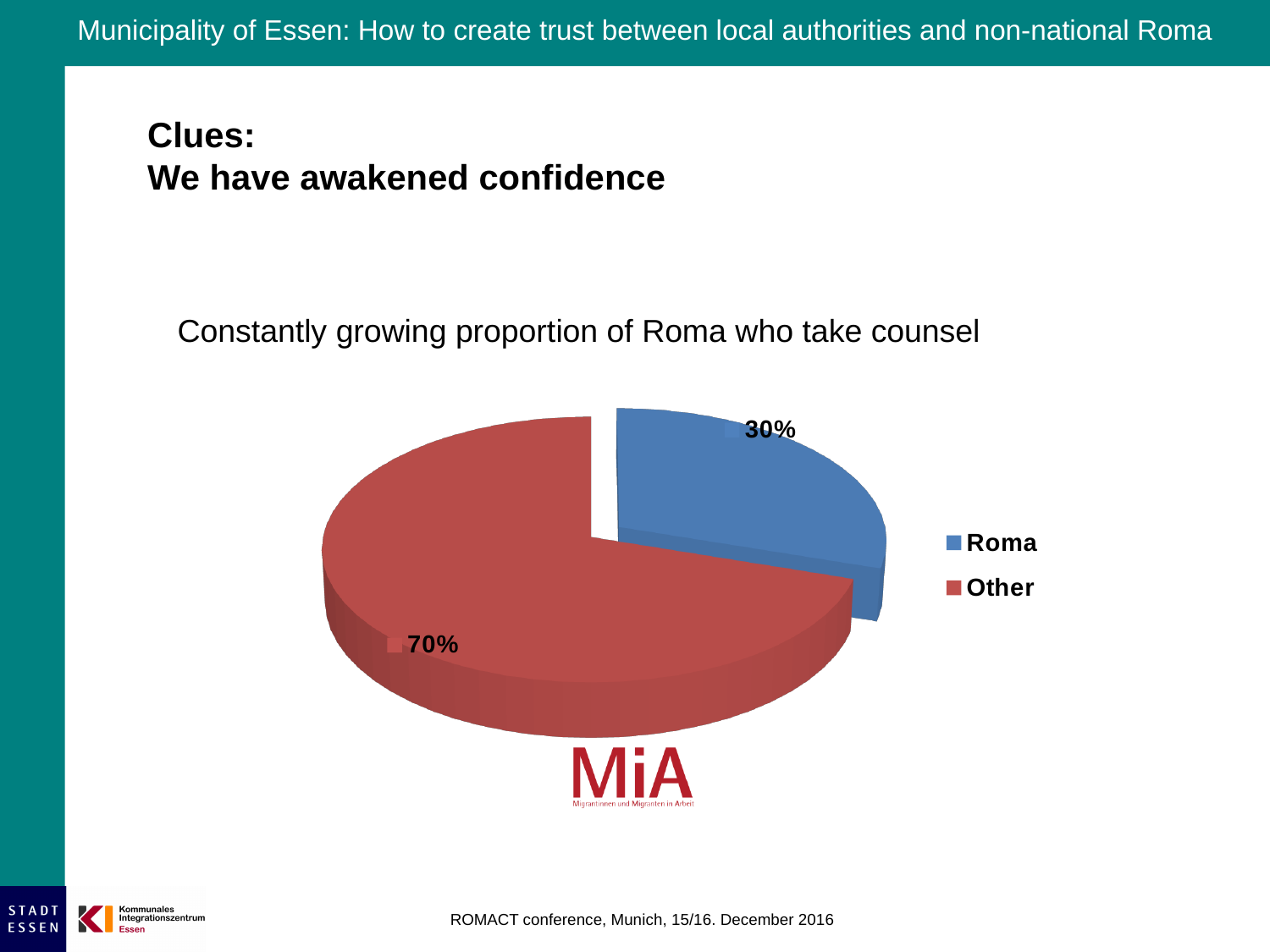
How many entries does the legend list? 2 What colour is the Roma slice in the pie chart? blue What kind of chart is shown on the slide? pie chart What percentage of the pie is labelled Other? 70% Which slice of the pie is the largest? Other How many slices does the pie chart have? 2 What colour is the Other slice in the pie chart? red Which slice is larger, Roma or Other? Other What is the difference in percentage points between the Other slice and the Roma slice? 40 What percentage of the pie is labelled Roma? 30% Which slice of the pie is the smallest? Roma What share of the pie does the Roma slice represent? 30%